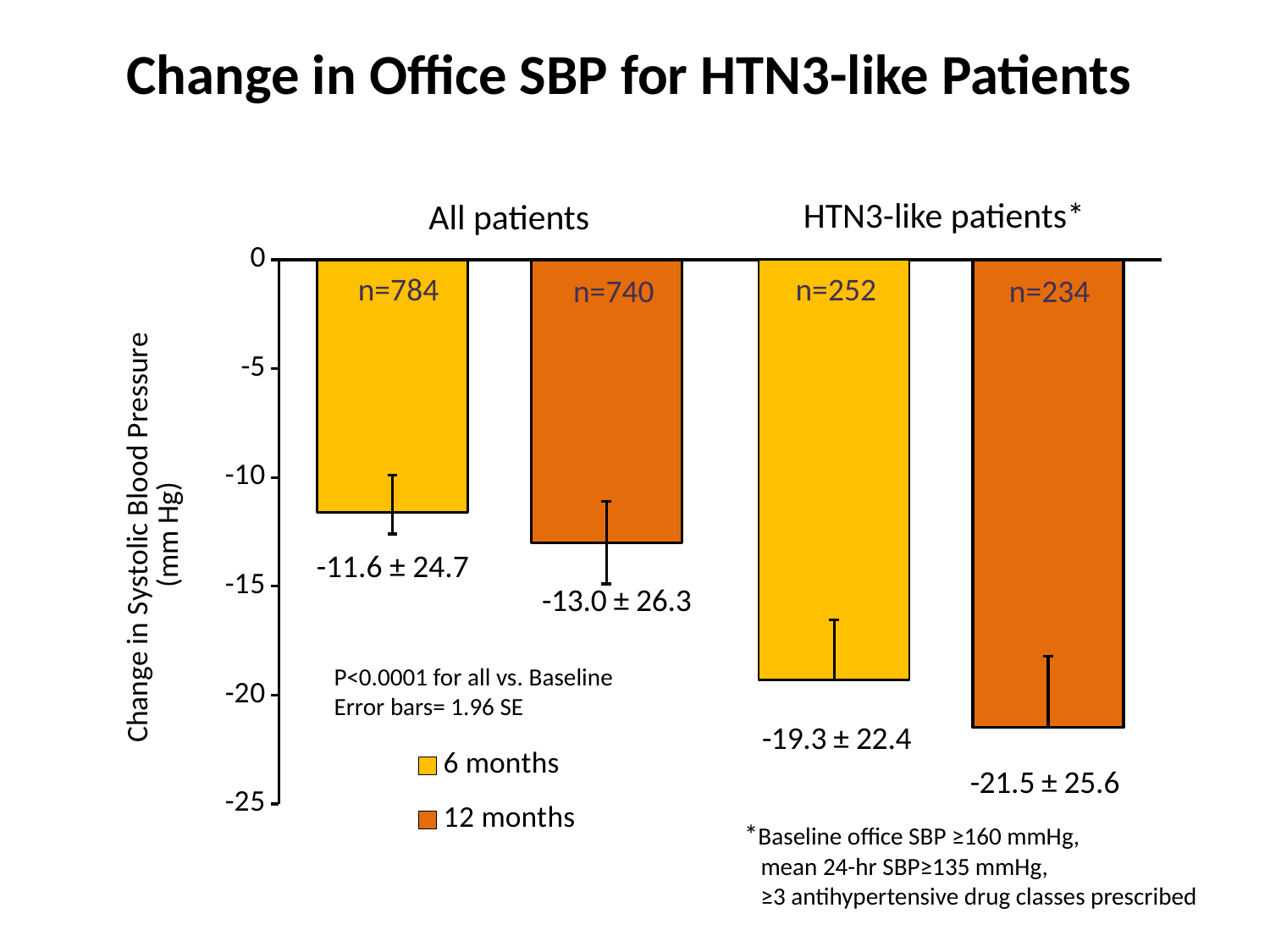
What is the difference between the mean 12-month and 6-month changes for HTN3-like patients? 2.2 Which bar shows the largest reduction in systolic blood pressure? HTN3-like patients, 12 months Is the mean reduction in SBP larger at 12 months for all patients or at 12 months for HTN3-like patients? 12 months for HTN3-like patients Which bar shows the smallest reduction in systolic blood pressure? All patients, 6 months What is the mean change in office SBP at 6 months for HTN3-like patients? -19.3 How many series does the legend list? 2 What is the change in office SBP at 6 months for all patients? -11.6 ± 24.7 What kind of chart is shown on the slide? bar chart What is the change in office SBP at 12 months for HTN3-like patients? -21.5 ± 25.6 How many patients (n) are in the 12-month all-patients group? n=740 How many patients (n) are in the 6-month HTN3-like group? n=252 Which colour represents the 12 months series in the legend? orange